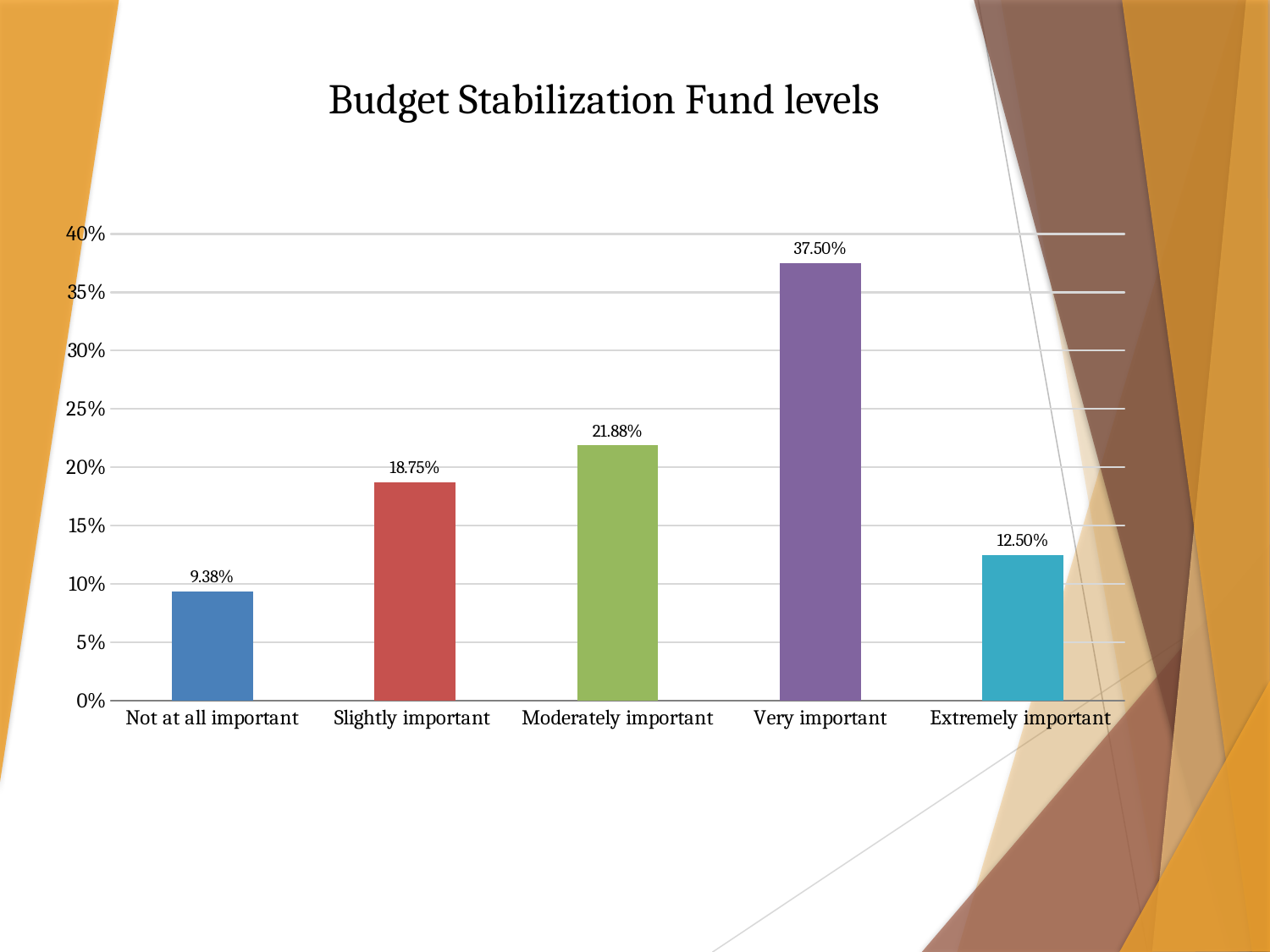
What kind of chart is shown on the slide? bar chart Which category has the highest value? Very important How many categories are shown on the x axis? 5 What is the value for Not at all important? 9.38% What is the value for Very important? 37.50% What is the difference between the values for Very important and Extremely important? 25.00% What is the value for Moderately important? 21.88% What is the title of the chart? Budget Stabilization Fund levels What is the difference between the values for Slightly important and Not at all important? 9.37% Is the value for Moderately important greater or less than 20%? greater Which is larger, the value for Slightly important or the value for Extremely important? Slightly important Which category has the lowest value? Not at all important